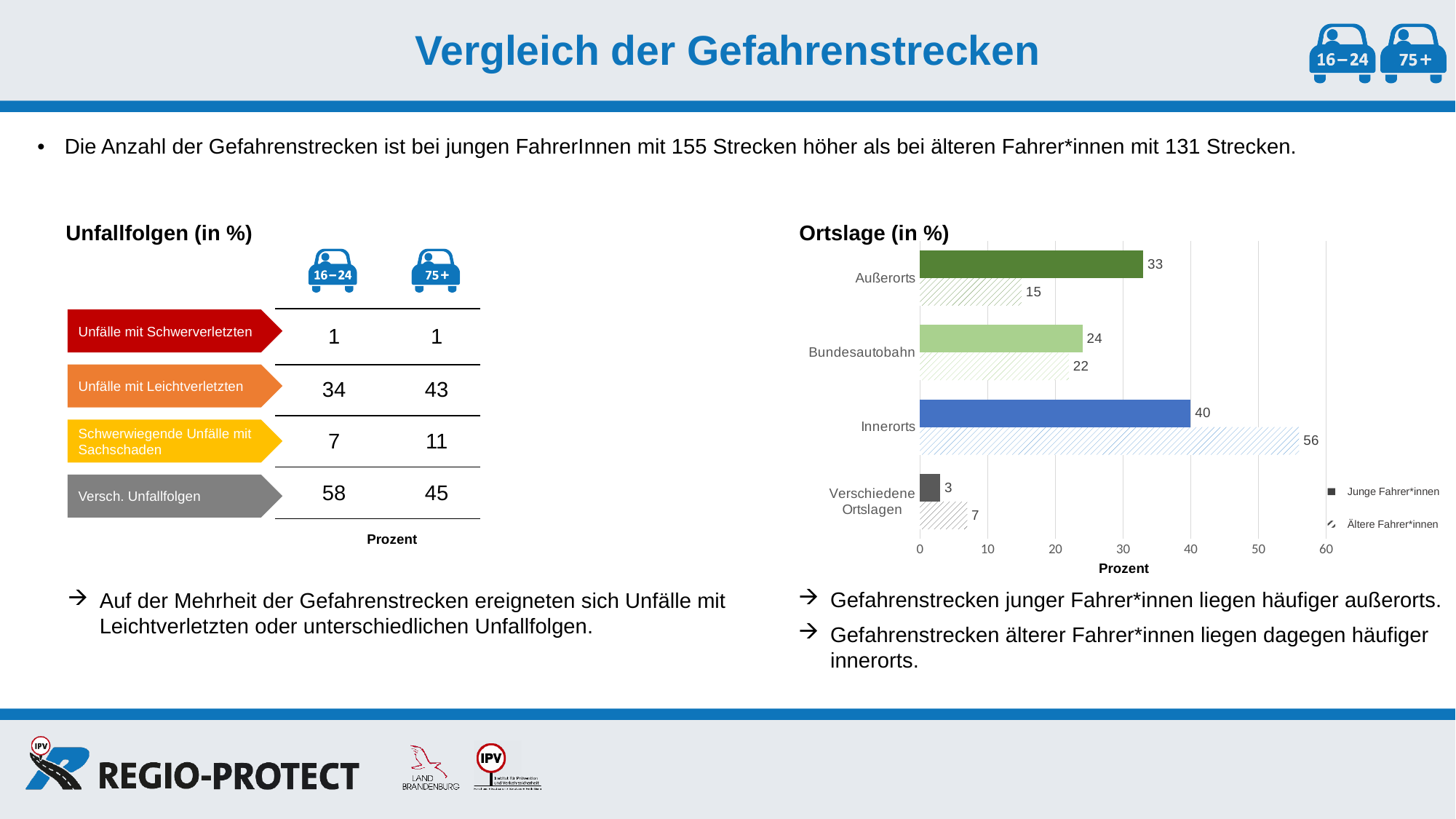
In the "Ortslage (in %)" chart, which category has the lowest value for Ältere Fahrer*innen? Verschiedene Ortslagen In the "Ortslage (in %)" chart, what is the value for Ältere Fahrer*innen at Innerorts? 56 In the "Ortslage (in %)" chart, what is the value for Junge Fahrer*innen at Außerorts? 33 How many series does the legend of the "Ortslage (in %)" chart list? 2 In the "Ortslage (in %)" chart, is the value for Ältere Fahrer*innen at Innerorts greater or less than 50? greater How many categories are shown in the "Ortslage (in %)" chart? 4 In the "Ortslage (in %)" chart, what is the difference between Ältere Fahrer*innen and Junge Fahrer*innen at Innerorts? 16 In the "Ortslage (in %)" chart, what is the value for Ältere Fahrer*innen at Bundesautobahn? 22 What kind of chart is the "Ortslage (in %)" chart? bar chart In the "Ortslage (in %)" chart, which category has the highest value for Junge Fahrer*innen? Innerorts In the "Ortslage (in %)" chart, which is larger at Verschiedene Ortslagen: Junge Fahrer*innen or Ältere Fahrer*innen? Ältere Fahrer*innen In the "Ortslage (in %)" chart, what is the difference between Junge Fahrer*innen and Ältere Fahrer*innen at Außerorts? 18